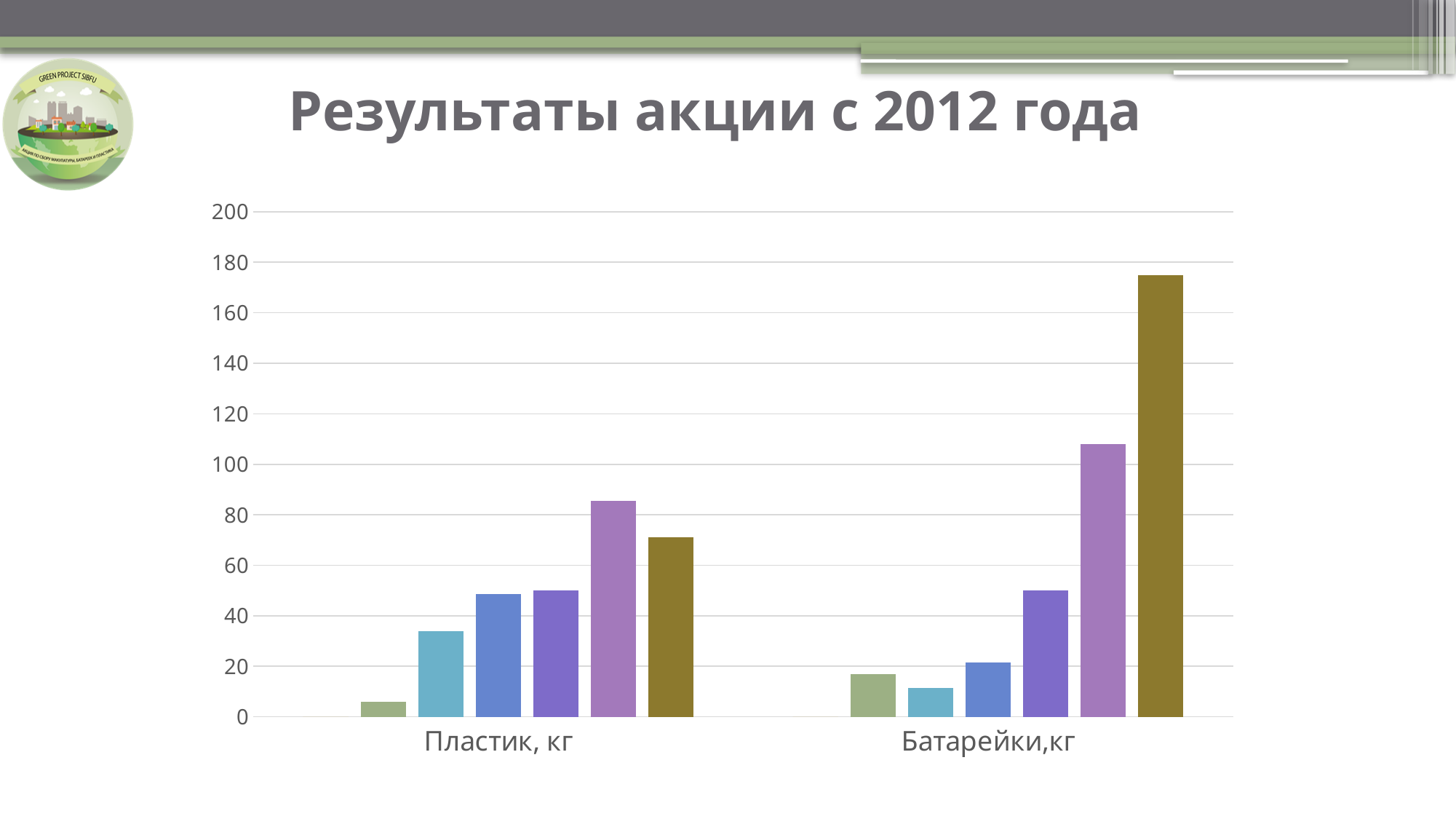
Which is larger: the teal bar for Пластик, кг or the teal bar for Батарейки,кг? Пластик, кг Which is larger: the dark gold (olive) bar for Пластик, кг or the dark gold (olive) bar for Батарейки,кг? Батарейки,кг What is the title of the slide with the chart? Результаты акции с 2012 года Which category has the tallest bar overall in the chart? Батарейки,кг Is the value of the light green bar for Пластик, кг greater or less than 20? less What kind of chart is shown on the slide? Bar chart How many categories are shown on the x axis of the chart? 2 Is the value of the dark gold (olive) bar for Пластик, кг greater or less than 80? less Within the Пластик, кг category, which coloured bar is the tallest? Light purple Is the value of the dark gold (olive) bar for Батарейки,кг greater or less than 160? greater Within the Пластик, кг category, which coloured bar is the shortest? Light green